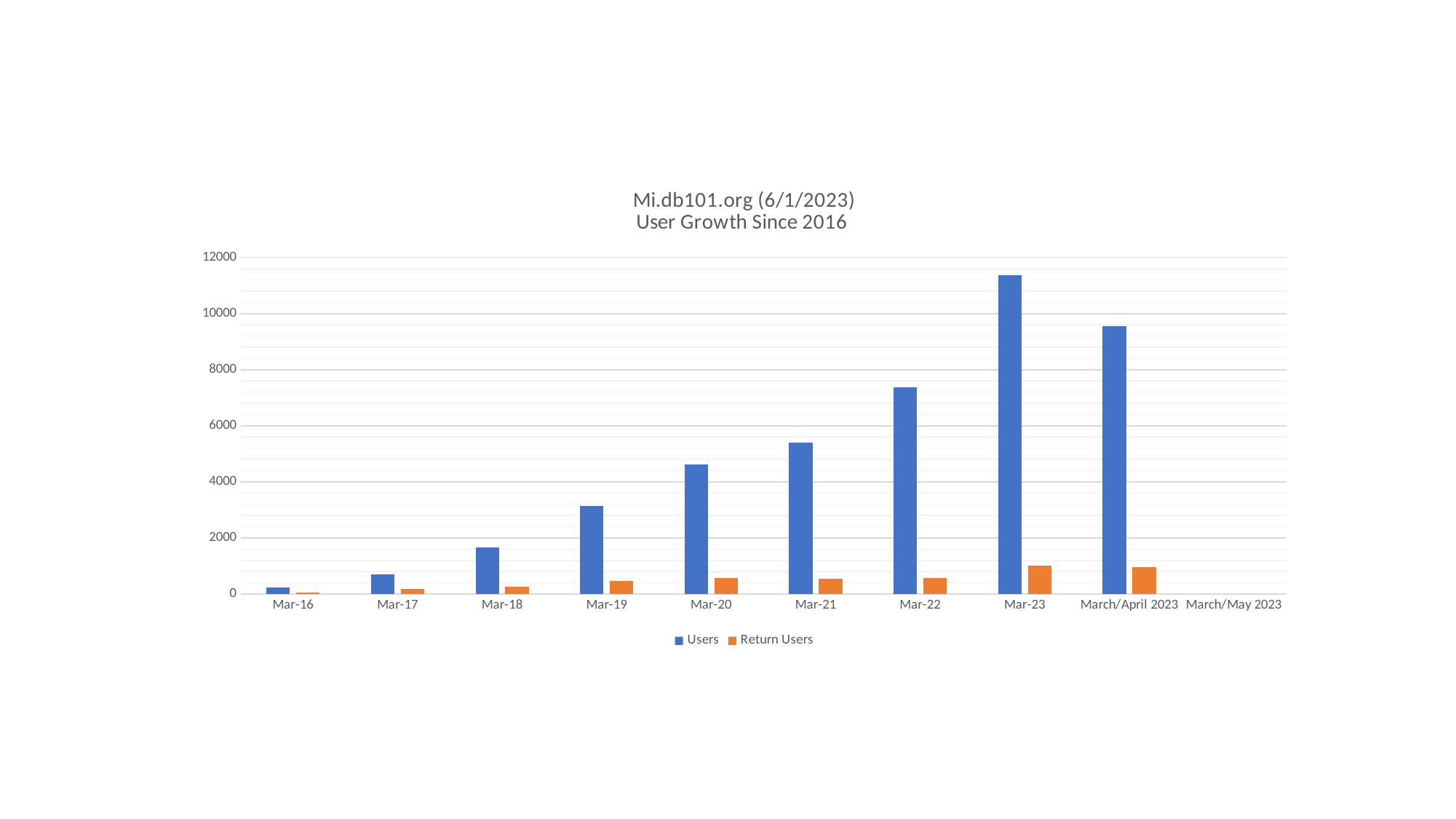
Is the value for Users in Mar-20 greater or less than 4000? greater How many series does the legend list? 2 Which is larger, the Users value for Mar-23 or for March/April 2023? Mar-23 Is the value for Users in March/April 2023 greater or less than 10000? less Do the Users values rise or fall from Mar-16 to Mar-23? rise What is the title of the chart? Mi.db101.org (6/1/2023) User Growth Since 2016 Which is larger, the Users value for Mar-21 or for Mar-20? Mar-21 What kind of chart is shown on the slide? bar chart Is the value for Users in Mar-18 greater or less than 2000? less Which category has the highest value for Users? Mar-23